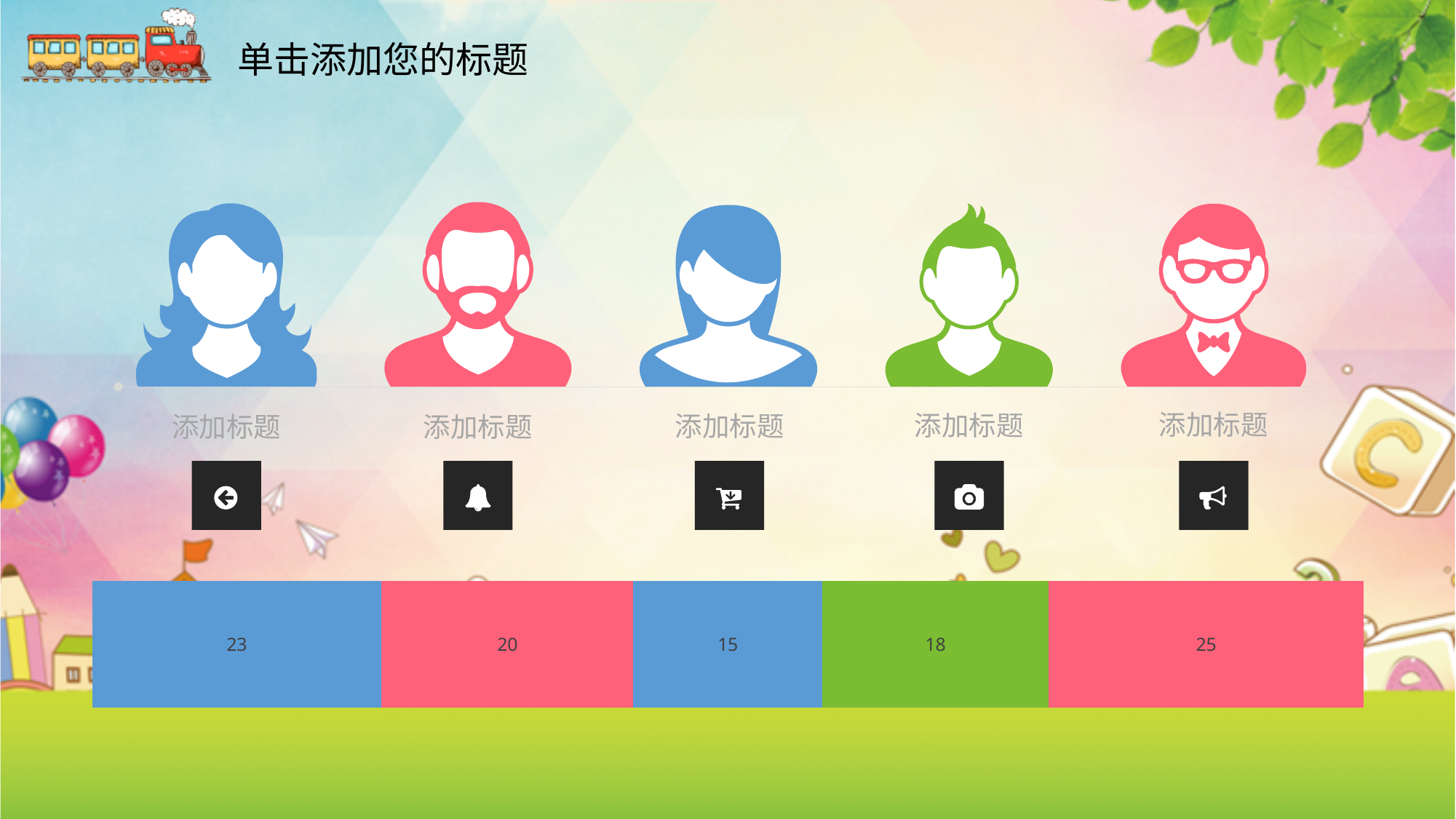
Which segment of the stacked bar has the highest value? The rightmost segment (25) What is the total of all the values shown in the stacked bar? 101 What is the difference between the second segment (20) and the third segment (15) of the stacked bar? 5 What colour is the segment of the stacked bar labelled 15? Blue How many segments does the stacked bar at the bottom of the slide contain? 5 Which segment of the stacked bar has the lowest value? The third segment from the left (15) What is the difference between the rightmost segment (25) and the leftmost segment (23) of the stacked bar? 2 Which is larger in the stacked bar: the second segment from the left or the fourth segment from the left? The second segment (20) What value is printed on the leftmost segment of the stacked bar at the bottom of the slide? 23 What value is printed on the green segment of the stacked bar? 18 What value is printed on the third segment from the left of the stacked bar? 15 What kind of chart is shown at the bottom of the slide? A stacked horizontal bar chart